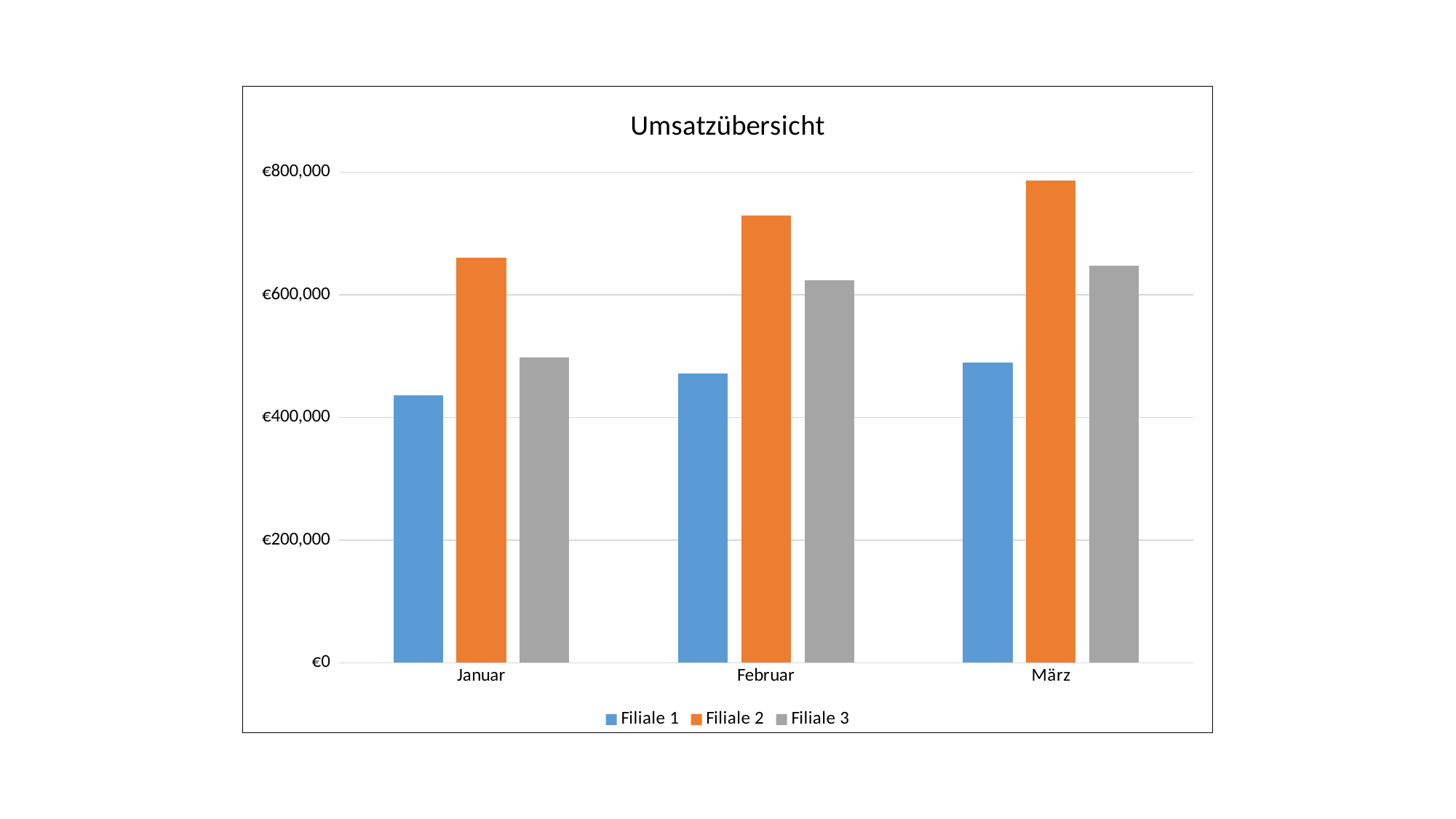
How many series does the legend list? 3 Which is larger in Februar, Filiale 1 or Filiale 3? Filiale 3 Is the value for Filiale 1 in Februar greater or less than €400,000? greater What type of chart is shown on the slide? Bar chart Which series has the highest value in Januar? Filiale 2 What is the title of the chart? Umsatzübersicht Do the values for Filiale 2 rise or fall from Januar to März? rise How many months are shown on the x axis? 3 Which series has the lowest value in März? Filiale 1 Is the value for Filiale 2 in Januar greater or less than €600,000? greater Is the value for Filiale 3 in Januar greater or less than €600,000? less In which month does Filiale 2 reach its highest value? März